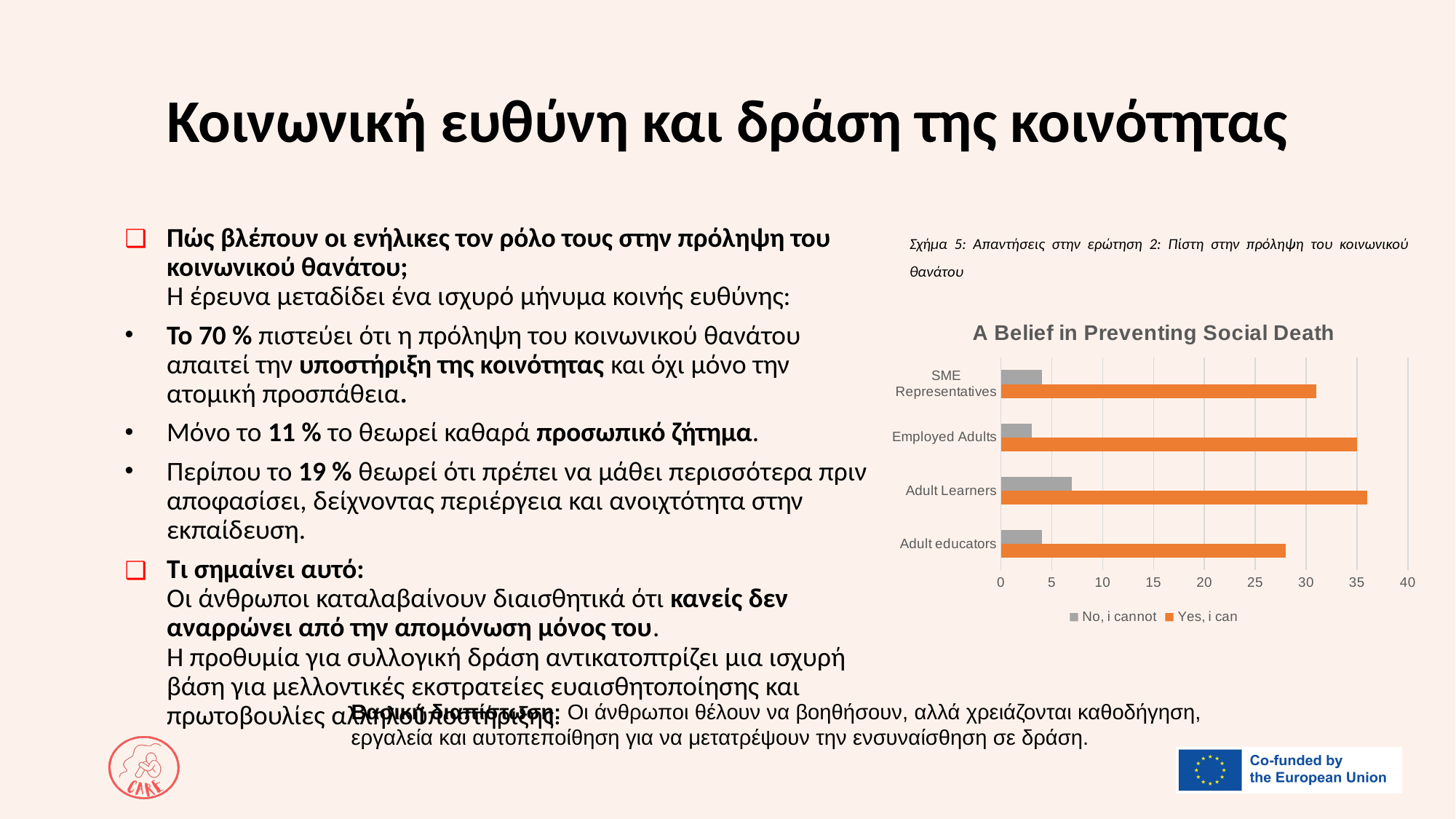
Is the 'Yes, i can' value for SME Representatives greater or less than 25? greater Which category has the highest value for the 'No, i cannot' series? Adult Learners How many categories are shown on the chart's vertical axis? 4 What is the title of the chart on the slide? A Belief in Preventing Social Death Which series is shown in orange in the chart? Yes, i can Is the 'Yes, i can' value for Adult educators greater or less than 30? less How many series does the chart's legend list? 2 For Adult educators, which is larger: the 'Yes, i can' value or the 'No, i cannot' value? Yes, i can Which category has the lowest value for the 'Yes, i can' series? Adult educators What kind of chart is shown on the slide? bar chart Is the 'No, i cannot' value for Adult Learners greater or less than 10? less